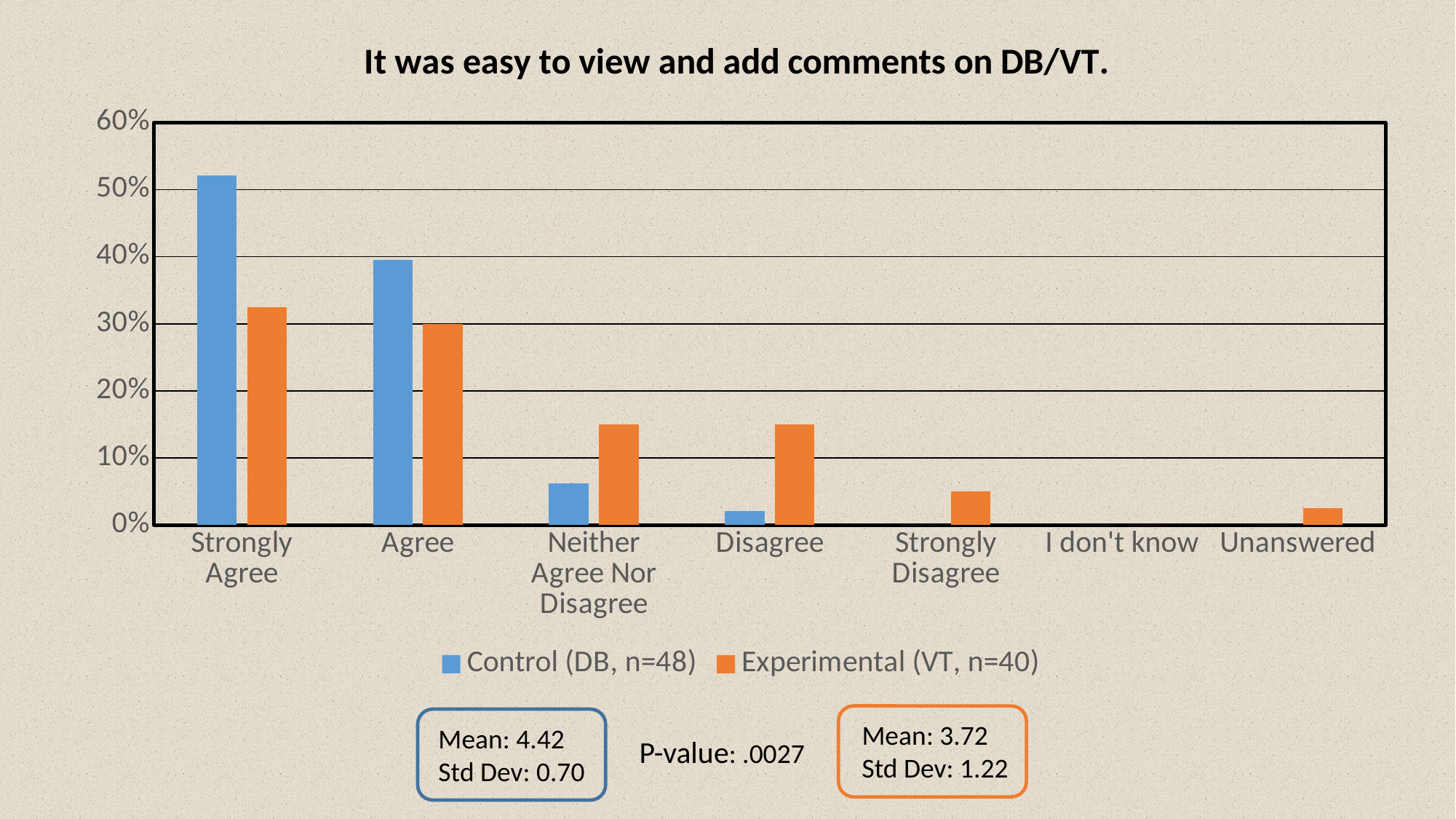
What is the title of the chart? It was easy to view and add comments on DB/VT. Is the Control (DB, n=48) value for Agree greater or less than 30%? greater What kind of chart is shown on the slide? bar chart How many series does the legend list? 2 Is the Control (DB, n=48) value for Disagree greater or less than 10%? less Which category has the highest value for the Control (DB, n=48) series? Strongly Agree For Strongly Agree, which series has the larger value, Control (DB, n=48) or Experimental (VT, n=40)? Control (DB, n=48) Is the Experimental (VT, n=40) value for Strongly Agree greater or less than 40%? less Which category has the highest value for the Experimental (VT, n=40) series? Strongly Agree For Neither Agree Nor Disagree, which series has the larger value, Control (DB, n=48) or Experimental (VT, n=40)? Experimental (VT, n=40) How many response categories are shown on the x axis? 7